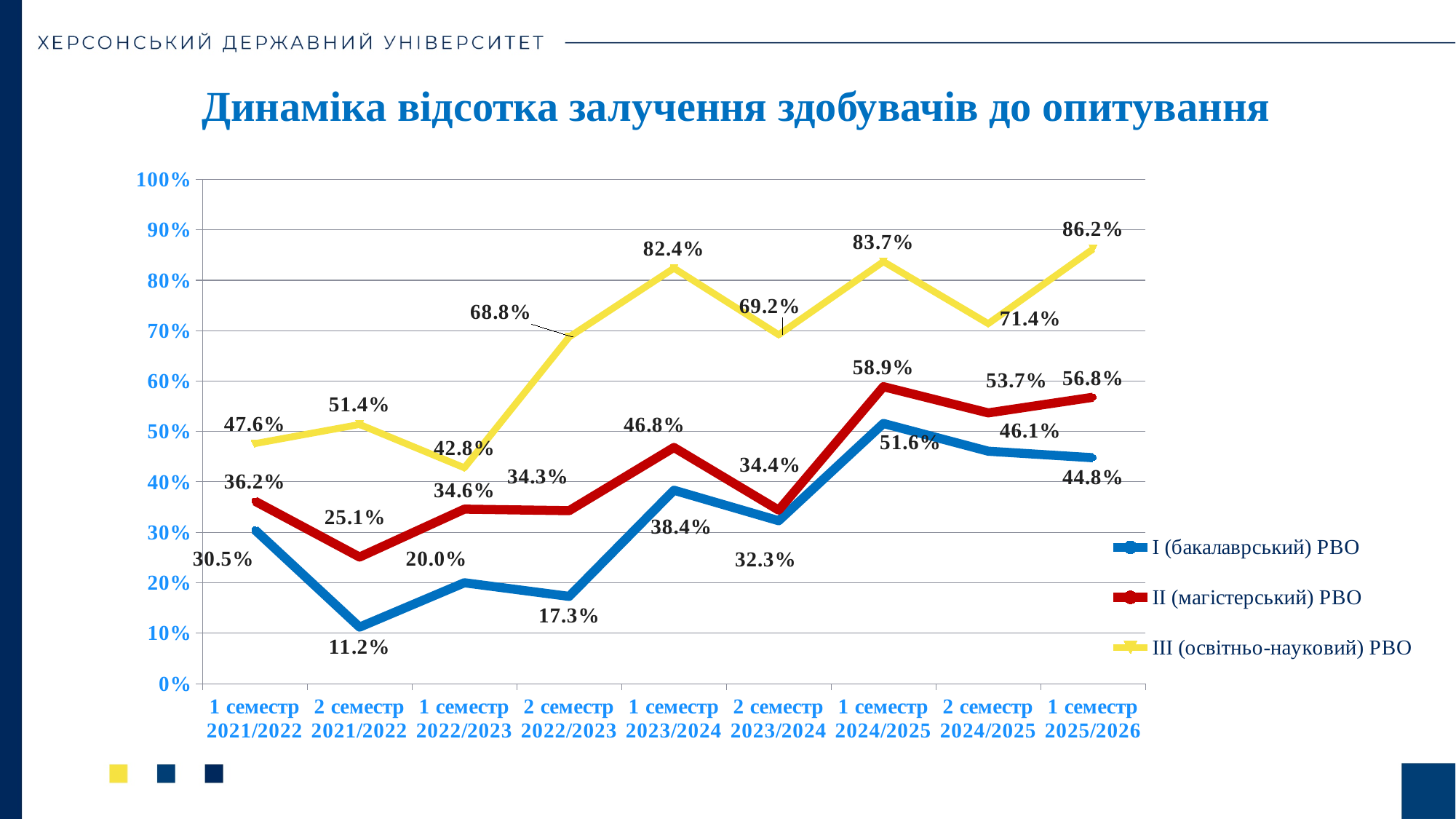
Which series has the higher value in 2 семестр 2023/2024: I (бакалаврський) РВО or II (магістерський) РВО? II (магістерський) РВО In which semester does I (бакалаврський) РВО reach its highest value? 1 семестр 2024/2025 What type of chart is shown on the slide? line chart What is the difference between III (освітньо-науковий) РВО and I (бакалаврський) РВО in 1 семестр 2025/2026? 41.4% How many series does the legend list? 3 Is the value for II (магістерський) РВО in 2 семестр 2021/2022 greater or less than 30%? less What is the value for III (освітньо-науковий) РВО in 1 семестр 2025/2026? 86.2% What is the value for II (магістерський) РВО in 1 семестр 2024/2025? 58.9% What is the title of the chart? Динаміка відсотка залучення здобувачів до опитування What is the value for I (бакалаврський) РВО in 2 семестр 2021/2022? 11.2% In which semester does III (освітньо-науковий) РВО have its lowest value? 1 семестр 2022/2023 How many semesters (points) are plotted along the x axis? 9